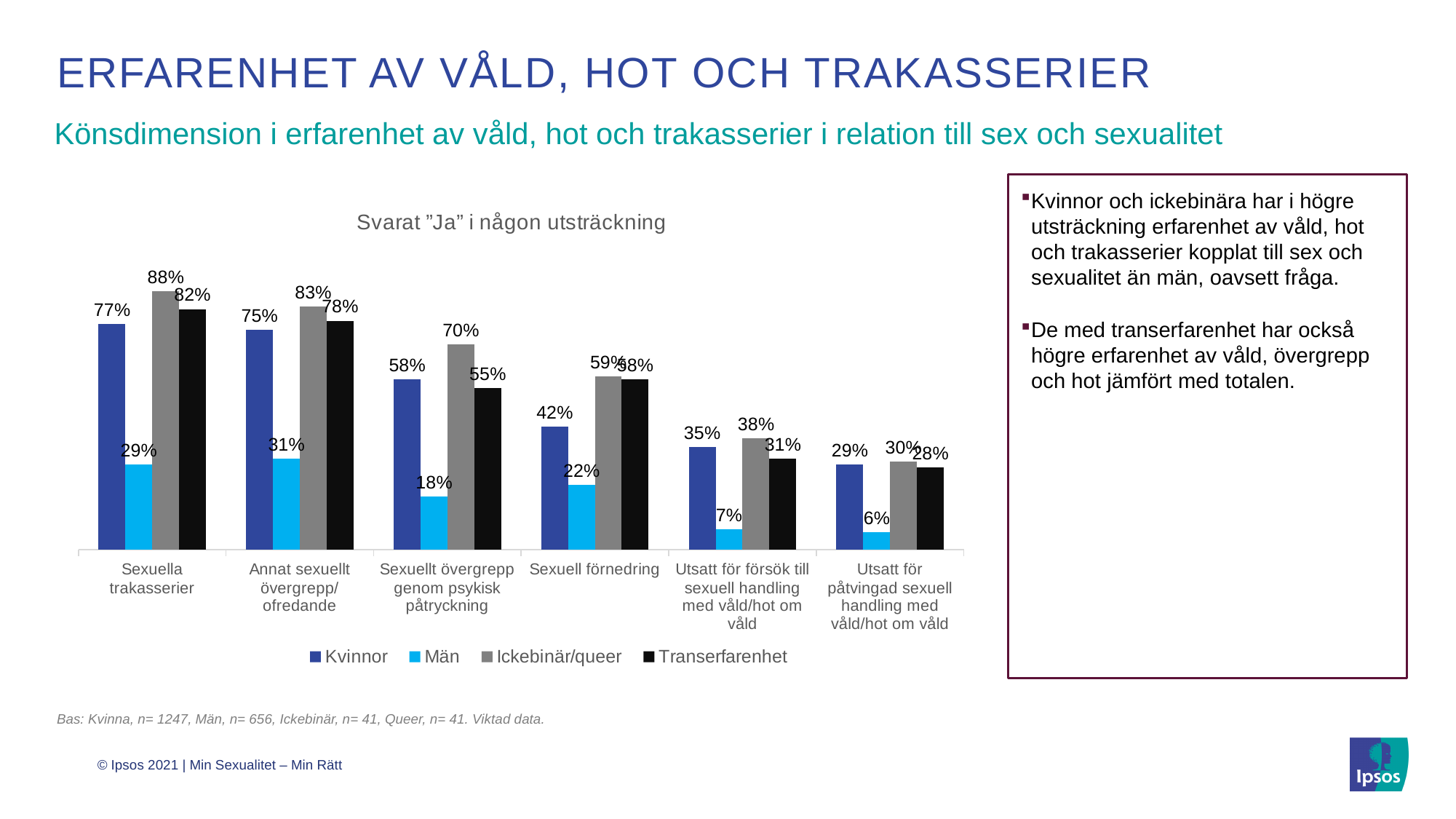
Which is larger: the Kvinnor value or the Transerfarenhet value in the Sexuellt övergrepp genom psykisk påtryckning category? Kvinnor What is the value for Transerfarenhet in the Annat sexuellt övergrepp/ofredande category? 78% What is the value for Kvinnor in the Sexuella trakasserier category? 77% What is the value for Ickebinär/queer in the Sexuell förnedring category? 59% Which category has the lowest value for Män? Utsatt för påtvingad sexuell handling med våld/hot om våld What is the difference between the Kvinnor and Män values in the Sexuell förnedring category? 20% Which series has the highest value in the Sexuella trakasserier category? Ickebinär/queer What kind of chart is shown on the slide? Bar chart What is the value for Män in the Sexuellt övergrepp genom psykisk påtryckning category? 18% How many series does the legend list? 4 How many categories are shown on the x axis? 6 What is the title of the chart? Svarat ”Ja” i någon utsträckning